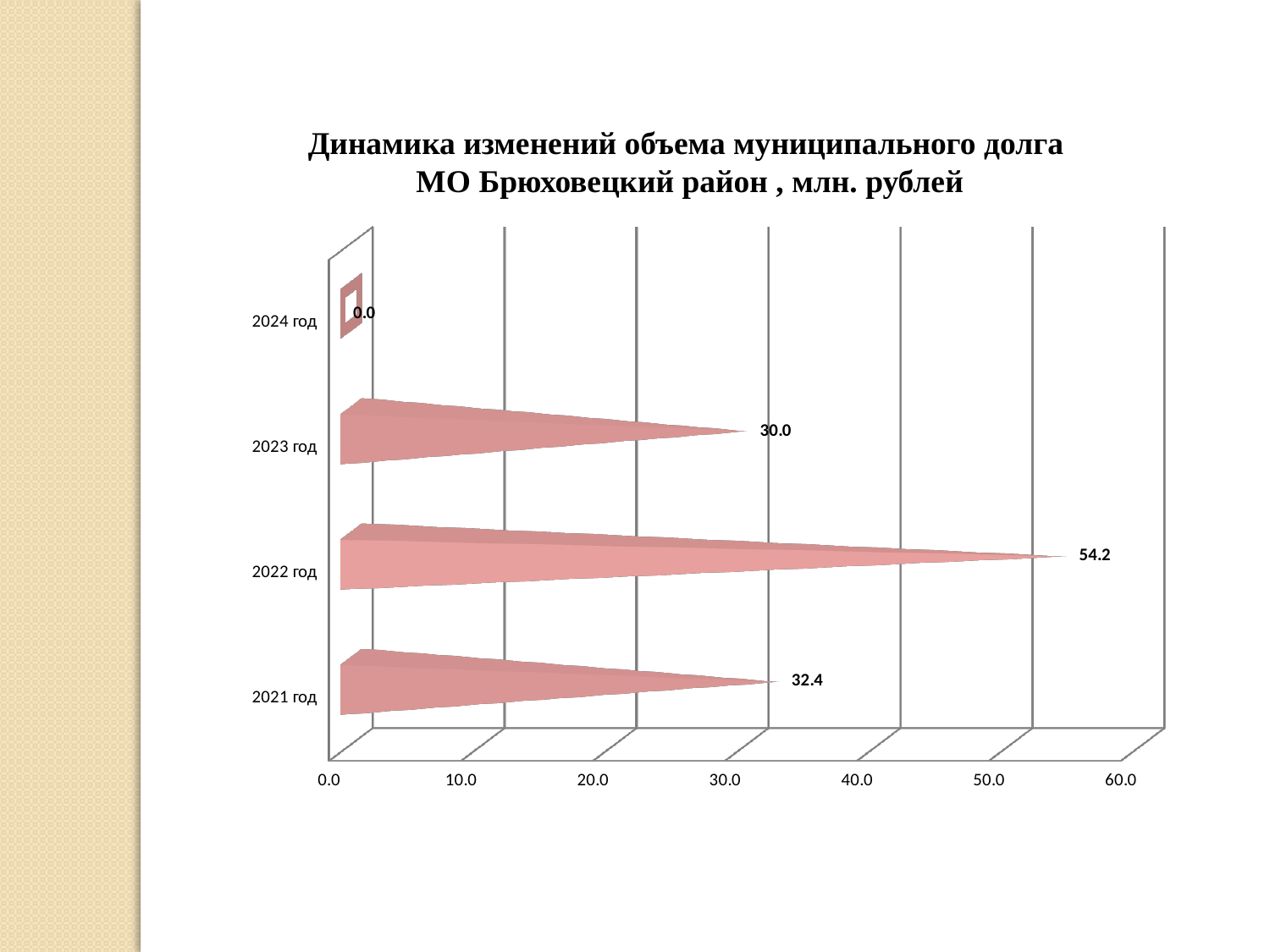
What is the value for 2021 год? 32.4 Which year has the highest value? 2022 год What is the title of the chart? Динамика изменений объема муниципального долга МО Брюховецкий район , млн. рублей What is the difference between the values for 2021 год and 2023 год? 2.4 What is the value for 2022 год? 54.2 How many years are shown on the chart? 4 What is the difference between the values for 2022 год and 2023 год? 24.2 Which is larger, the value for 2021 год or the value for 2023 год? 2021 год What is the value for 2024 год? 0.0 Which year has the lowest value? 2024 год What is the value for 2023 год? 30.0 What kind of chart is shown on the slide? bar chart